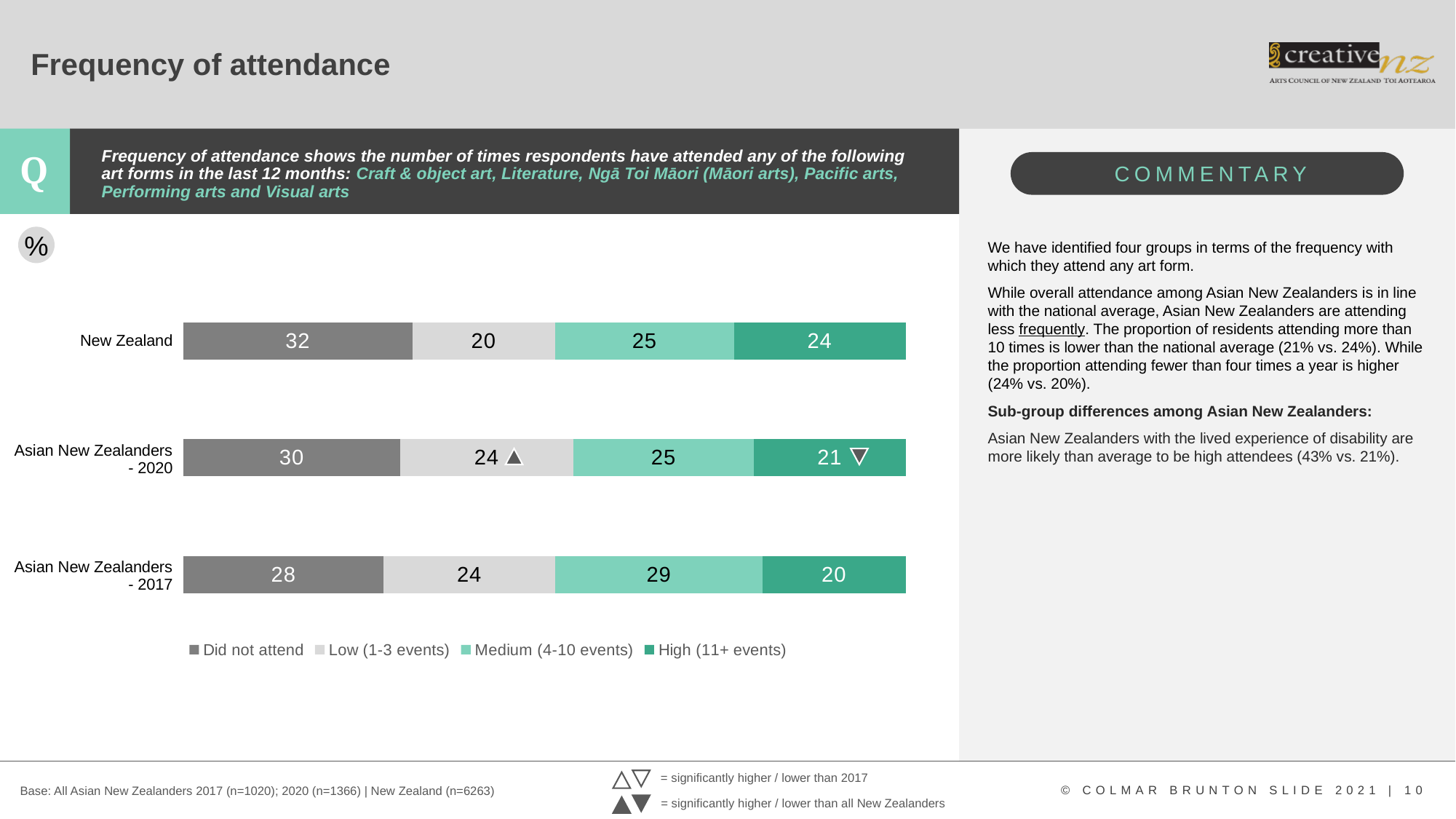
What kind of chart is shown on the slide? Stacked bar chart What is the difference between the 'High (11+ events)' values for New Zealand and Asian New Zealanders - 2020? 3 What is the 'High (11+ events)' value for Asian New Zealanders - 2020? 21 What is the total of the stacked bar for Asian New Zealanders - 2020? 100 Which category has the lowest 'High (11+ events)' value? Asian New Zealanders - 2017 Which category has the highest 'Did not attend' value? New Zealand Which is larger: the 'Medium (4-10 events)' value for Asian New Zealanders - 2017 or for Asian New Zealanders - 2020? Asian New Zealanders - 2017 What is the 'Medium (4-10 events)' value for Asian New Zealanders - 2017? 29 What is the 'Did not attend' value for New Zealand? 32 What is the 'Low (1-3 events)' value for New Zealand? 20 How many categories (bars) are shown in the chart? 3 How many series does the chart legend list? 4